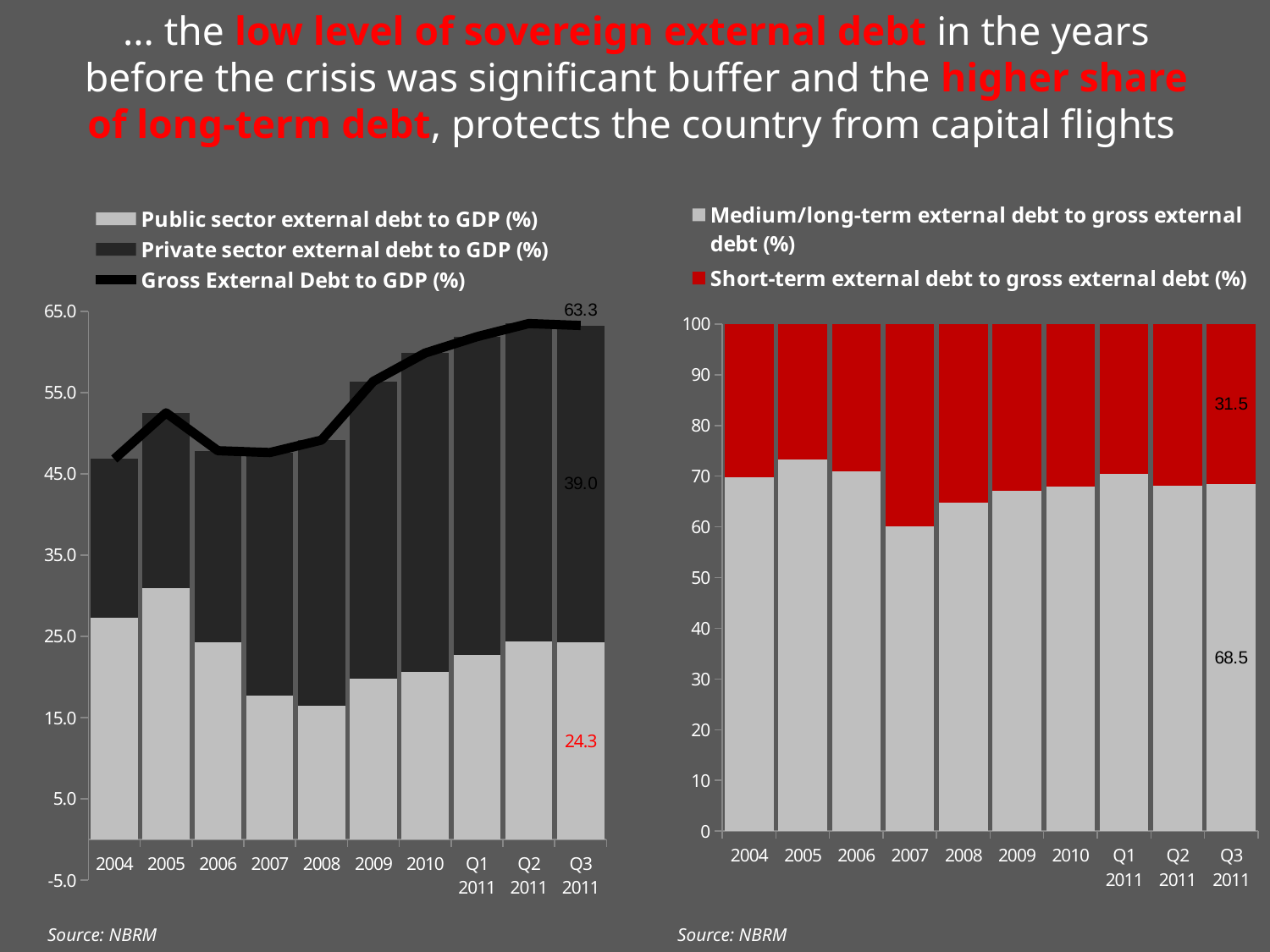
In the right chart, which period has the lowest Medium/long-term external debt to gross external debt share? 2007 In the right chart, what is the Medium/long-term external debt to gross external debt (%) value for Q3 2011? 68.5 In the left chart, what is the Gross External Debt to GDP (%) value for Q3 2011? 63.3 In the left chart, what is the total of the stacked bar for Q3 2011 (public plus private sector external debt to GDP)? 63.3 In the left chart, is the Public sector external debt to GDP value for 2005 greater or less than 25.0? greater In the right chart, what is the Short-term external debt to gross external debt (%) value for Q3 2011? 31.5 What kind of chart is the right chart? bar chart In the left chart, which is larger: the Public sector external debt to GDP value for 2005 or for 2008? 2005 How many time periods are shown on the x axis of the left chart? 10 In the left chart, what is the Public sector external debt to GDP (%) value for Q3 2011? 24.3 In the left chart, what is the Private sector external debt to GDP (%) value for Q3 2011? 39.0 How many series does the legend of the left chart list? 3